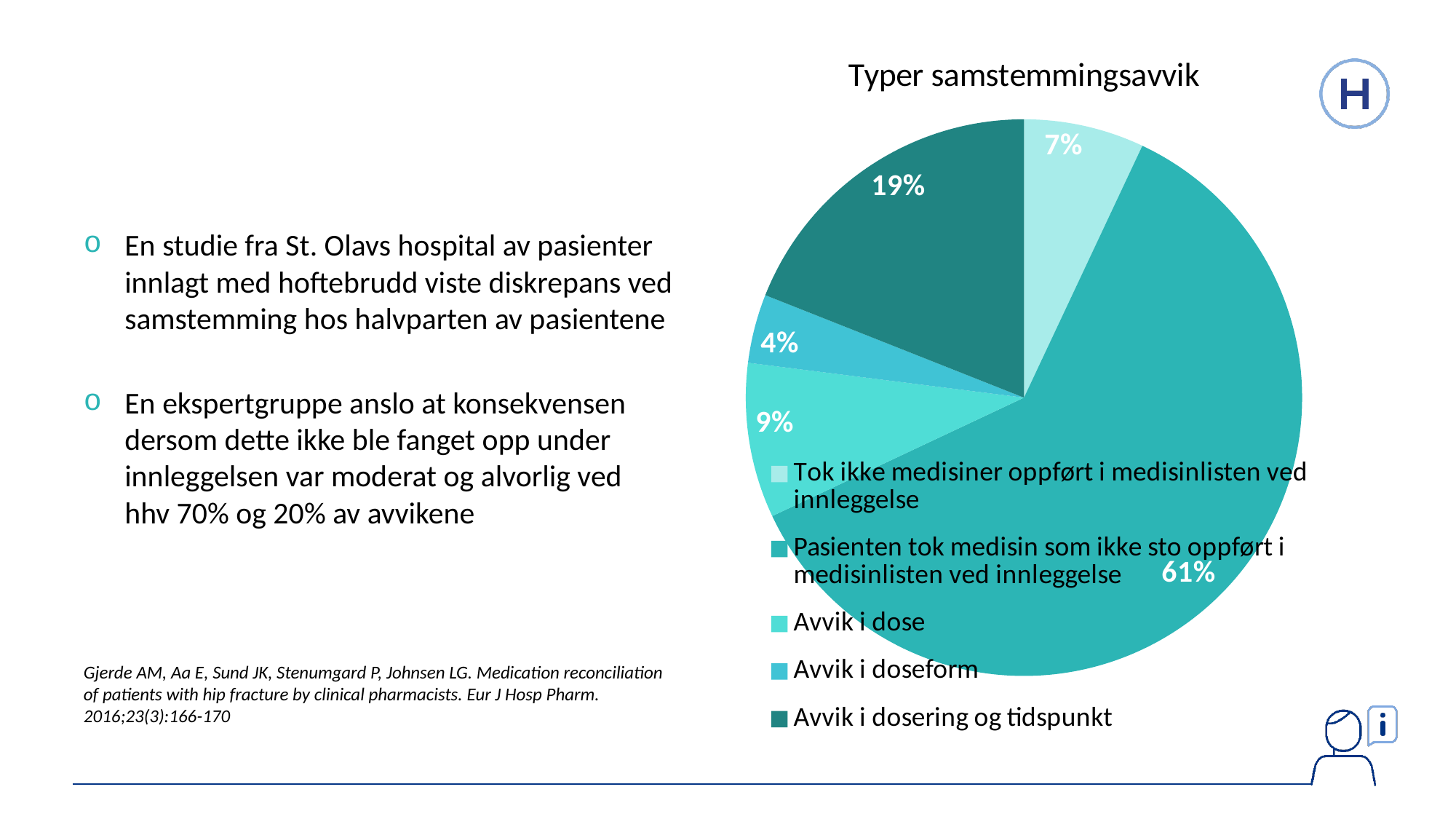
What share of the pie is 'Avvik i doseform'? 4% Which category has the smallest slice of the pie? Avvik i doseform How many slices does the pie chart have? 5 What share of the pie is 'Pasienten tok medisin som ikke sto oppført i medisinlisten ved innleggelse'? 61% Which category has the largest slice of the pie? Pasienten tok medisin som ikke sto oppført i medisinlisten ved innleggelse What is the difference in percentage points between 'Avvik i dosering og tidspunkt' and 'Avvik i dose'? 10 What share of the pie is 'Avvik i dosering og tidspunkt'? 19% Which is larger, the slice for 'Avvik i dose' or the slice for 'Tok ikke medisiner oppført i medisinlisten ved innleggelse'? Avvik i dose What is the title of the chart? Typer samstemmingsavvik What kind of chart is shown on the slide? pie chart